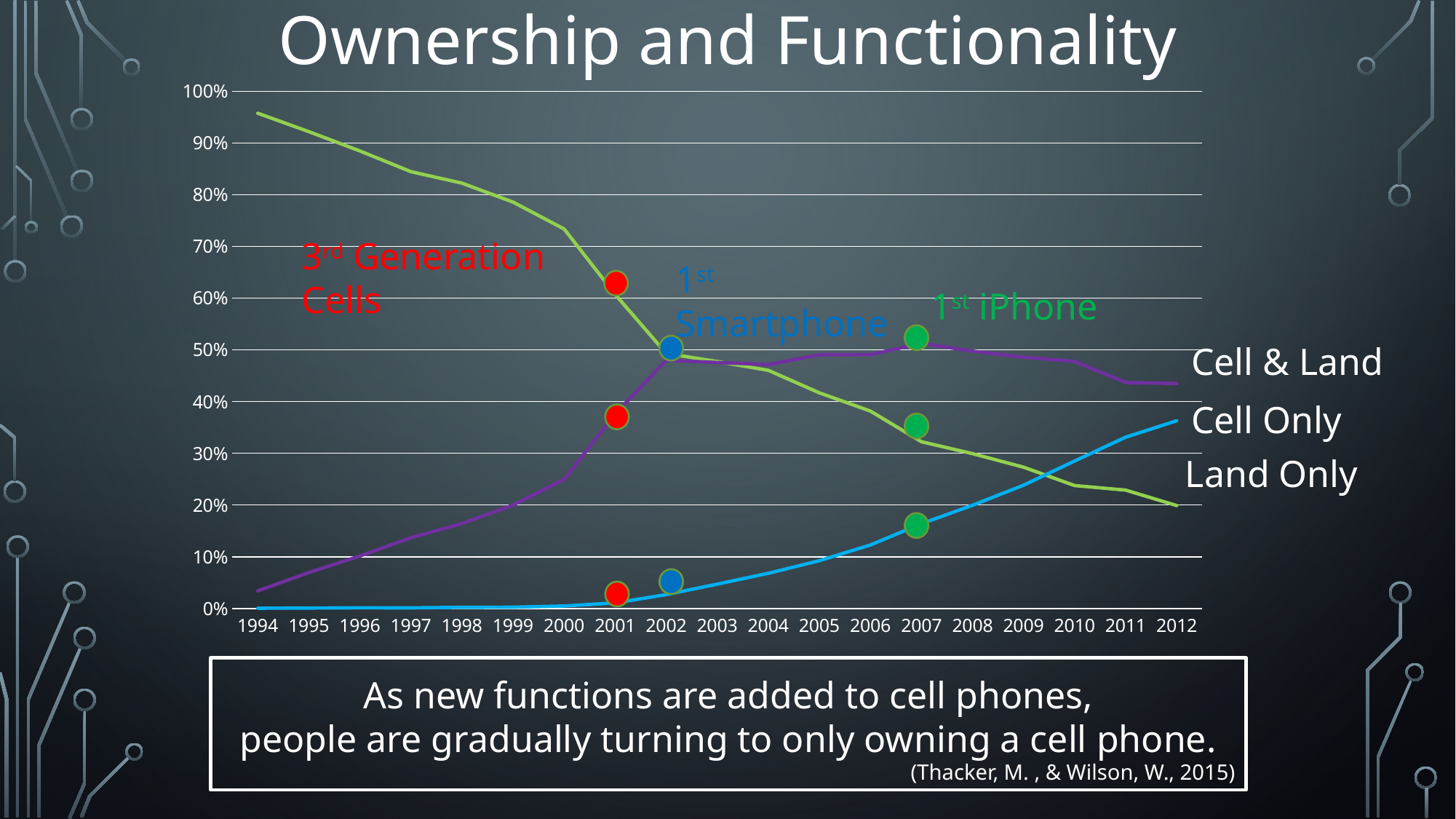
What is the title of the chart? Ownership and Functionality What kind of chart is shown on the slide? Line chart Does the Land Only line rise or fall from 1994 to 2012? Fall Which series has the highest value in 1994? Land Only Does the Cell Only line rise or fall from 1994 to 2012? Rise In 2012, which is larger: Cell & Land or Cell Only? Cell & Land Is the value for Cell & Land in 1994 greater or less than 10%? less Is the value for Land Only in 1994 greater or less than 90%? greater Is the value for Cell Only in 2012 greater or less than 30%? greater How many series are plotted on the chart? 3 In which year is the '1st iPhone' marker placed on the chart? 2007 How many years are shown along the x axis? 19